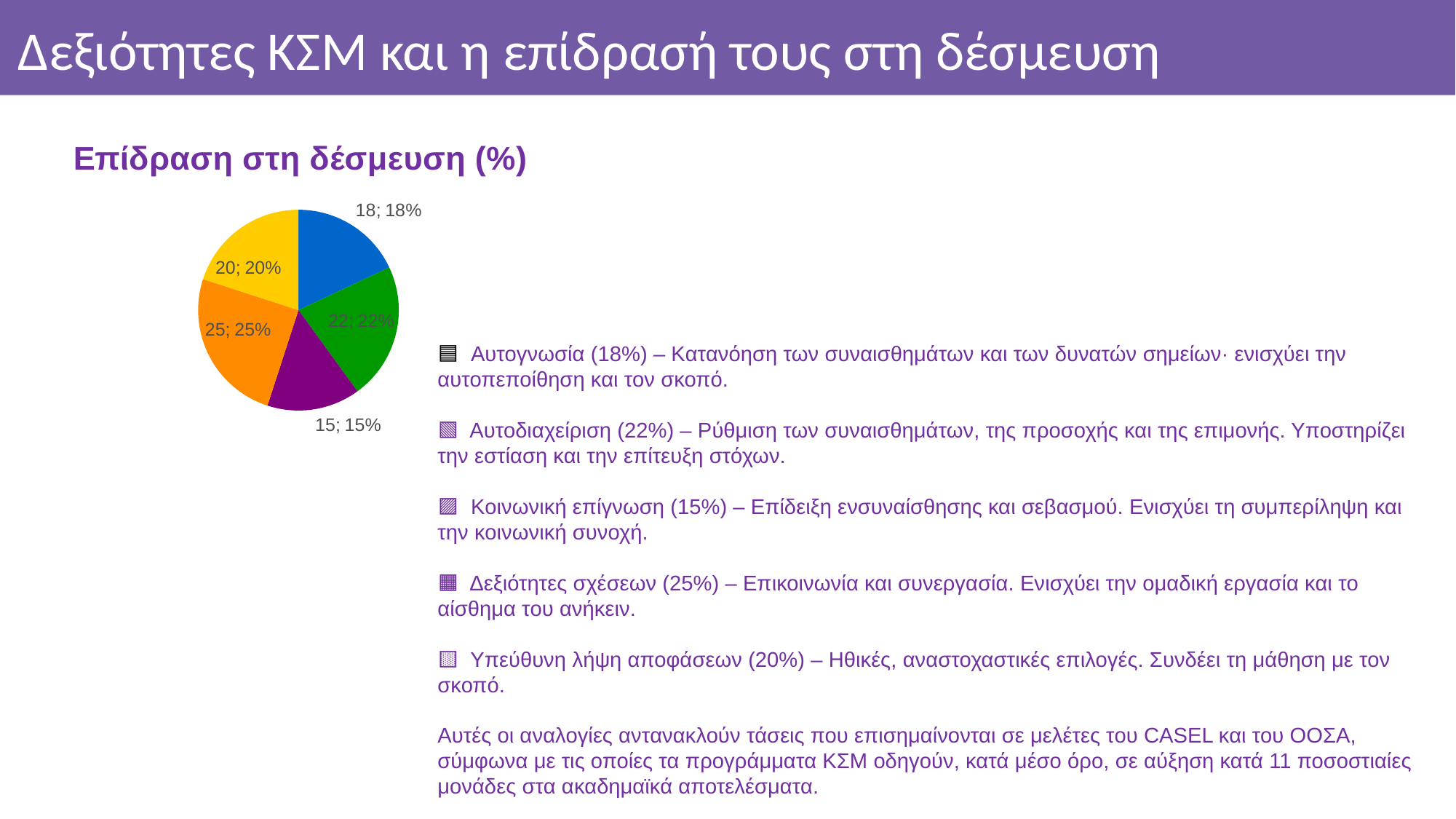
What percentage is shown on the blue slice of the pie chart? 18% Which slice is larger, the blue slice or the green slice? the green slice (22%) What percentage is shown on the yellow slice of the pie chart? 20% What is the largest slice's share of the pie? 25% What is the title of the chart? Επίδραση στη δέσμευση (%) What is the difference in percentage points between the largest slice (25%) and the smallest slice (15%)? 10 What percentage is shown on the purple slice of the pie chart? 15% What percentage is shown on the green slice of the pie chart? 22% What kind of chart is shown on the slide? pie chart What is the smallest slice's share of the pie? 15% What percentage is shown on the orange slice of the pie chart? 25% How many slices does the pie chart have? 5